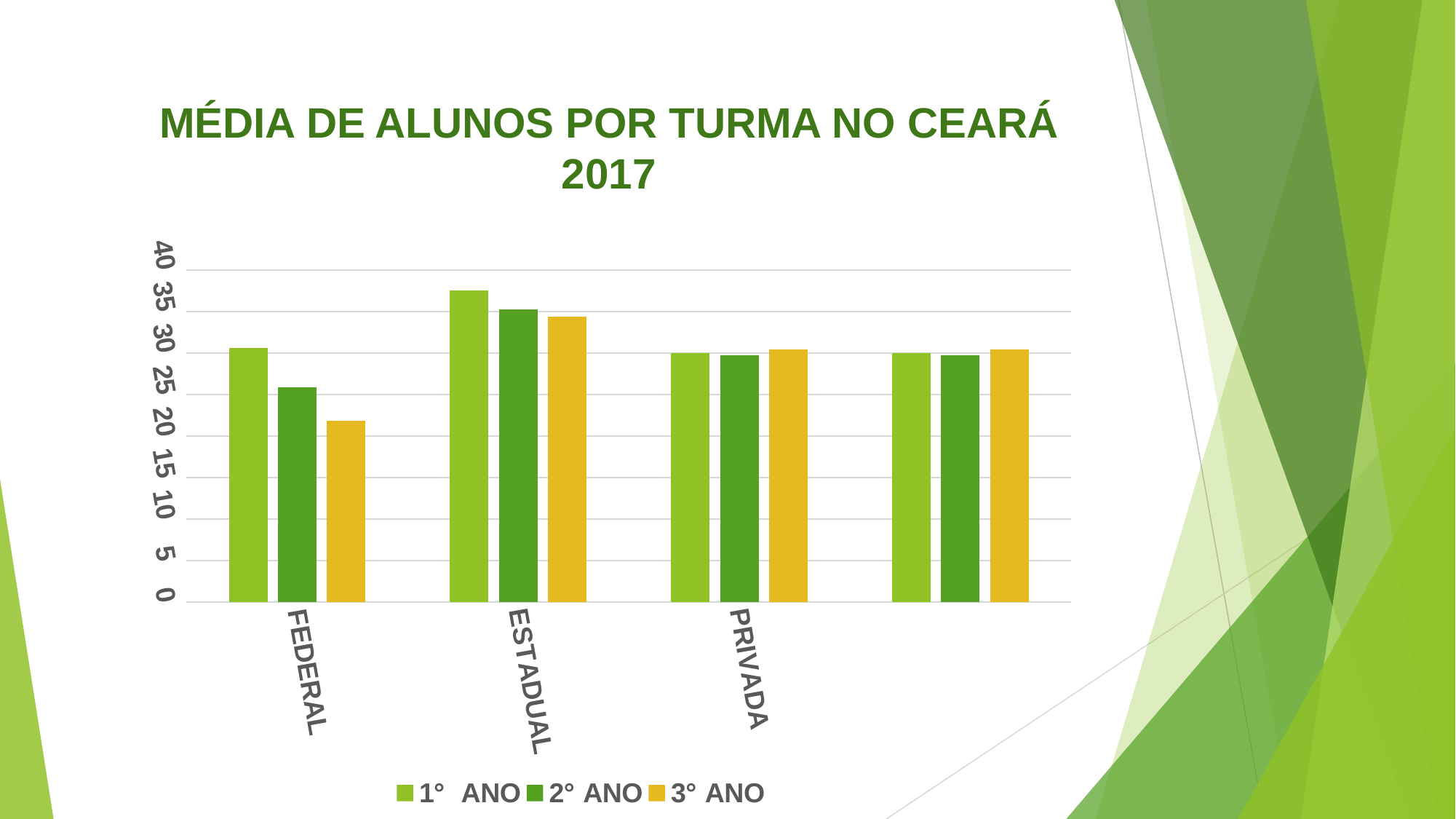
How many series does the legend list? 3 In the FEDERAL category, which is larger: 1° ANO or 3° ANO? 1° ANO Is the value for 1° ANO in ESTADUAL greater or less than 35? greater Is the value for 2° ANO in FEDERAL greater or less than 20? greater Which labelled category has the lowest value for 3° ANO? FEDERAL Which series is shown in yellow in the legend? 3° ANO Is the value for 1° ANO in FEDERAL greater or less than 25? greater Which labelled category has the highest value for 1° ANO? ESTADUAL What is the title of the chart? MÉDIA DE ALUNOS POR TURMA NO CEARÁ 2017 What kind of chart is shown on the slide? bar chart In the FEDERAL category, do the values rise or fall from 1° ANO to 3° ANO? fall